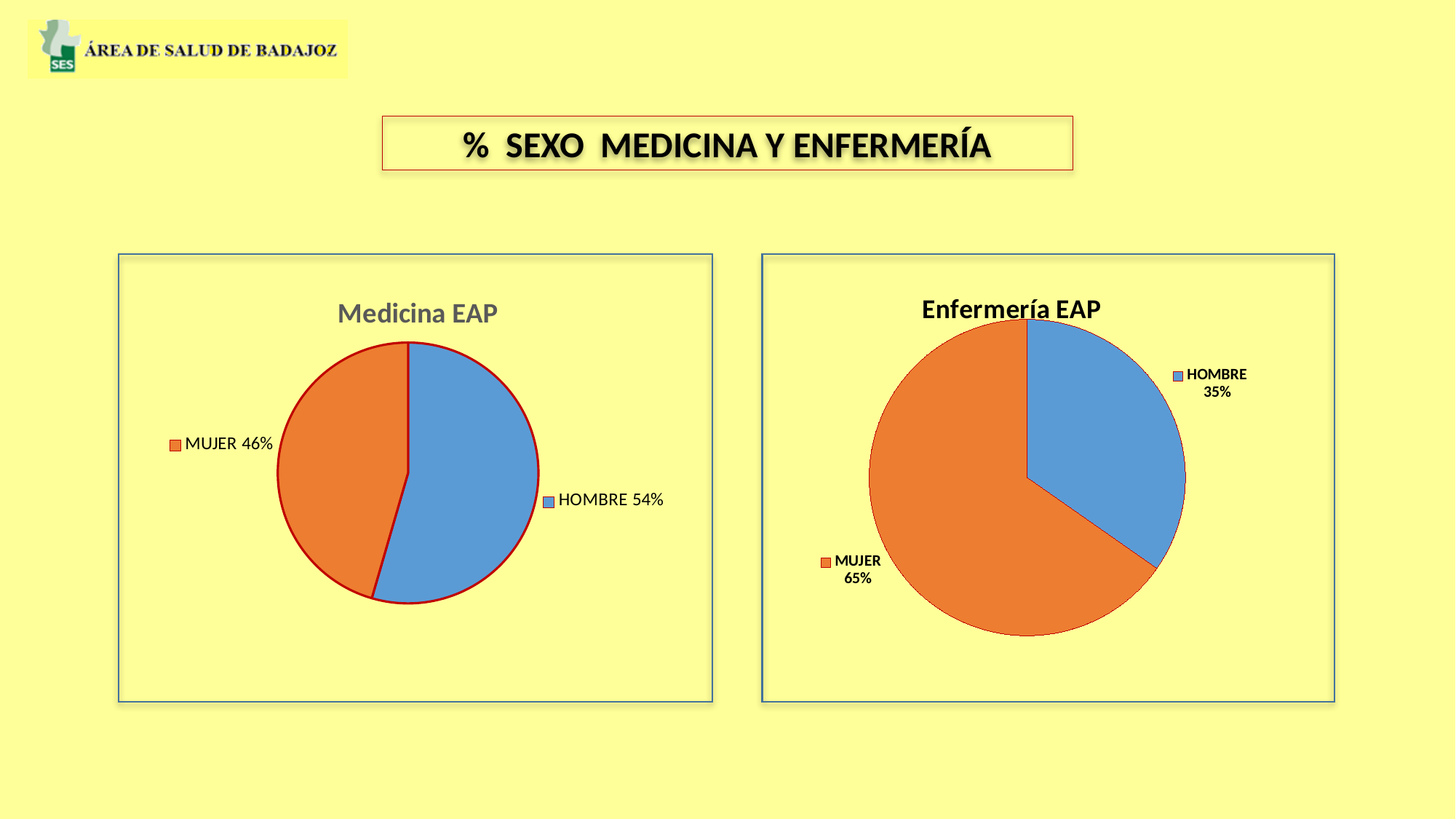
What type of chart is the Medicina EAP chart? Pie chart Is the MUJER share larger in the Medicina EAP chart or in the Enfermería EAP chart? Enfermería EAP In the Enfermería EAP chart, what is the difference between the MUJER and HOMBRE percentages? 30% In the Enfermería EAP chart, what percentage is shown for MUJER? 65% In the Enfermería EAP chart, what percentage is shown for HOMBRE? 35% In the Enfermería EAP chart, which colour represents MUJER? Orange In the Medicina EAP chart, what is the difference between the HOMBRE and MUJER percentages? 8% In the Enfermería EAP chart, which category has the smaller share? HOMBRE How many slices does the Enfermería EAP pie chart have? 2 In the Medicina EAP chart, what percentage is shown for MUJER? 46% In the Medicina EAP chart, what percentage is shown for HOMBRE? 54% In the Medicina EAP chart, which category has the larger share? HOMBRE